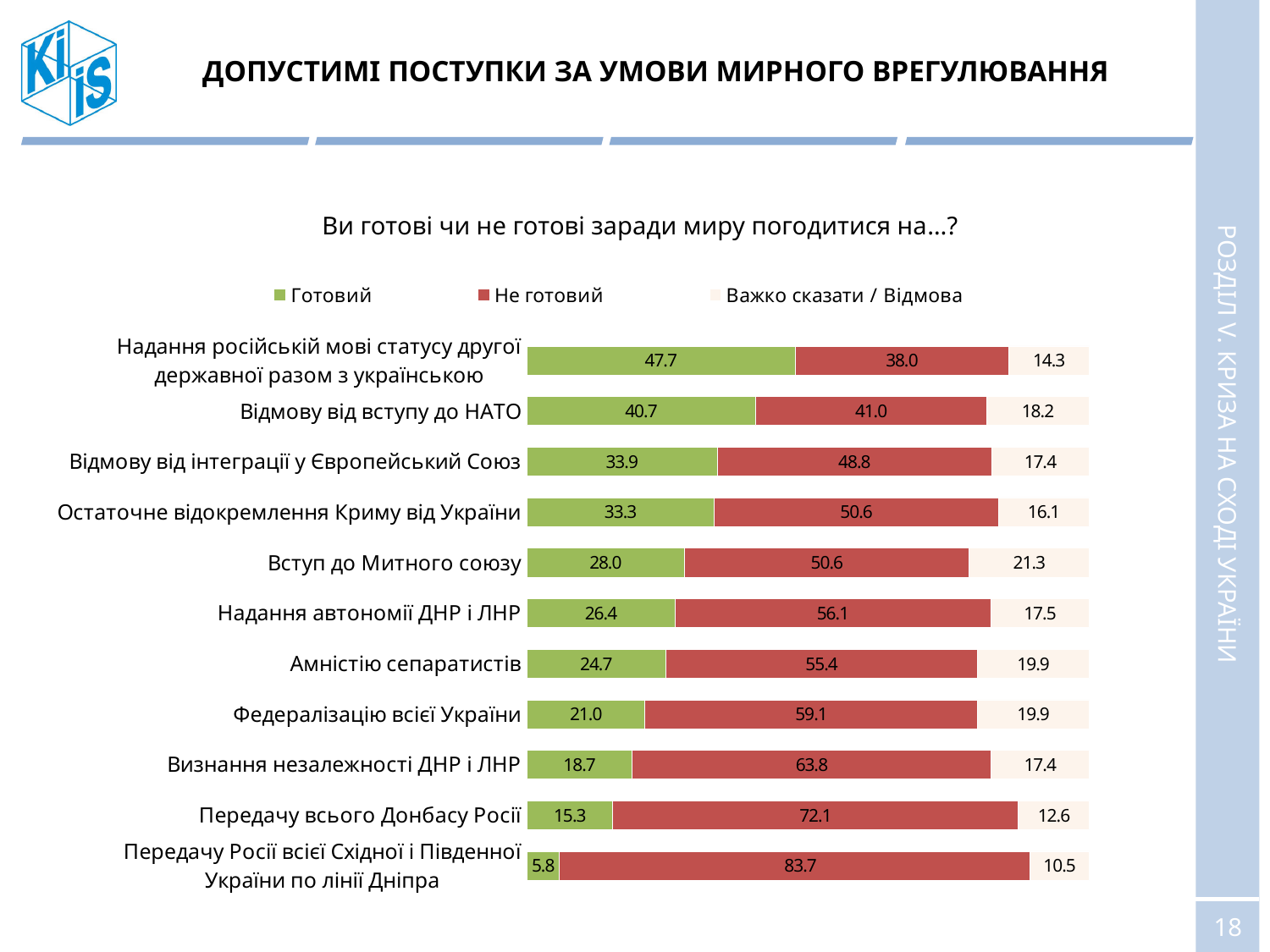
Which category has the lowest "Готовий" value? Передачу Росії всієї Східної і Південної України по лінії Дніпра Which is larger for "Амністію сепаратистів": the "Готовий" value or the "Не готовий" value? Не готовий What kind of chart is shown on the slide? Stacked bar chart What is the value of "Не готовий" for "Передачу всього Донбасу Росії"? 72.1 What is the total of the stacked bar for "Федералізацію всієї України"? 100.0 What is the value of "Важко сказати / Відмова" for "Вступ до Митного союзу"? 21.3 Which category has the highest "Не готовий" value? Передачу Росії всієї Східної і Південної України по лінії Дніпра What is the difference between the "Не готовий" and "Готовий" values for "Визнання незалежності ДНР і ЛНР"? 45.1 How many categories are shown in the chart? 11 What is the value of "Готовий" for "Відмову від вступу до НАТО"? 40.7 How many series does the legend list? 3 Which category has the highest "Готовий" value? Надання російській мові статусу другої державної разом з українською